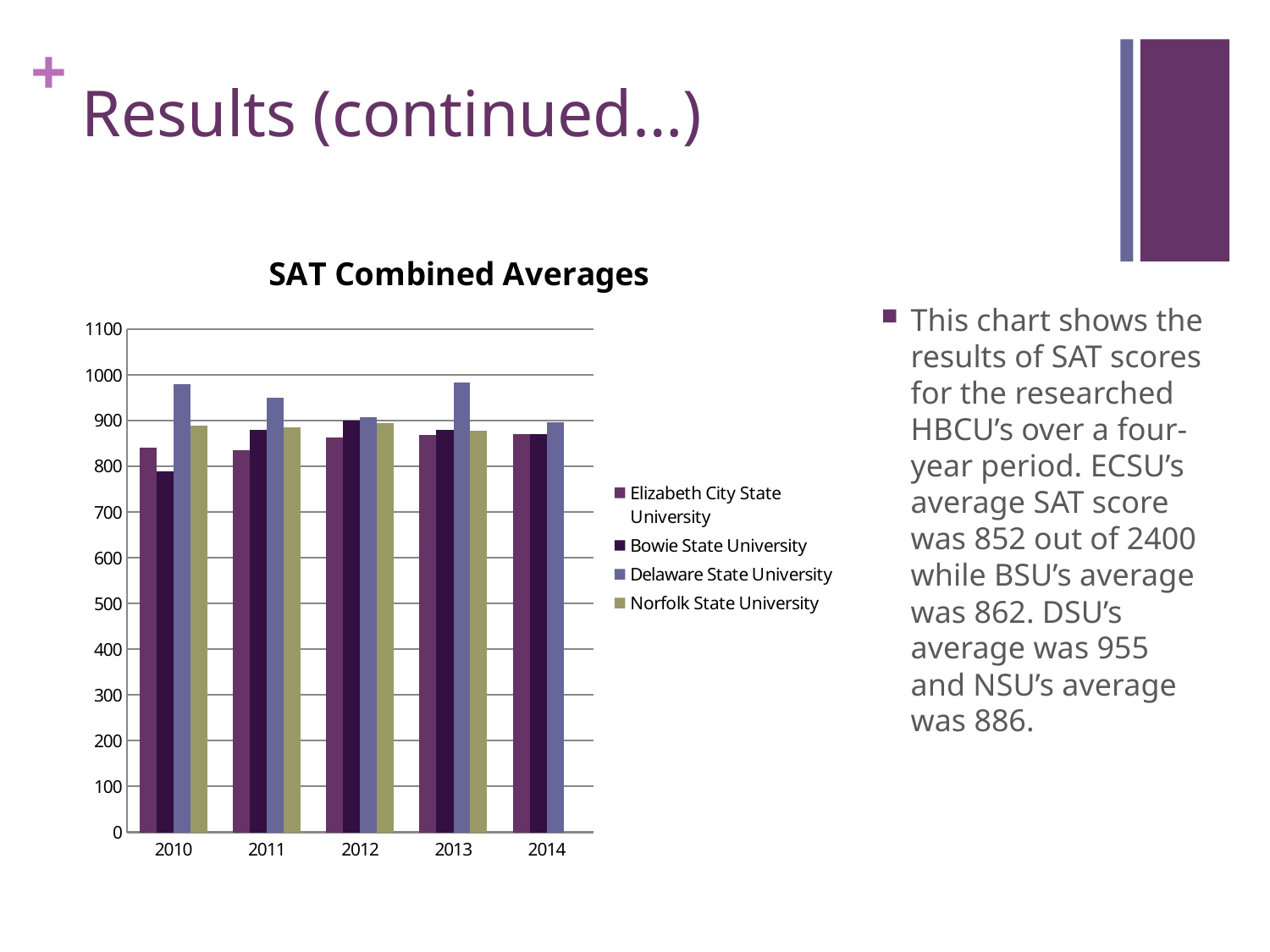
What is the title of the chart? SAT Combined Averages How many series does the legend list? 4 In 2013, which is larger: the value for Delaware State University or the value for Bowie State University? Delaware State University Does the value for Delaware State University rise or fall from 2010 to 2012? fall Which university has the lowest bar in 2010? Bowie State University What kind of chart is shown on the slide? bar chart Is the value for Bowie State University in 2010 greater or less than 800? less Is the value for Delaware State University in 2010 greater or less than 900? greater Which university has the highest bar in 2010? Delaware State University How many years are shown along the x axis? 5 Is the value for Elizabeth City State University in 2010 greater or less than 900? less Which university has no bar shown for 2014? Norfolk State University